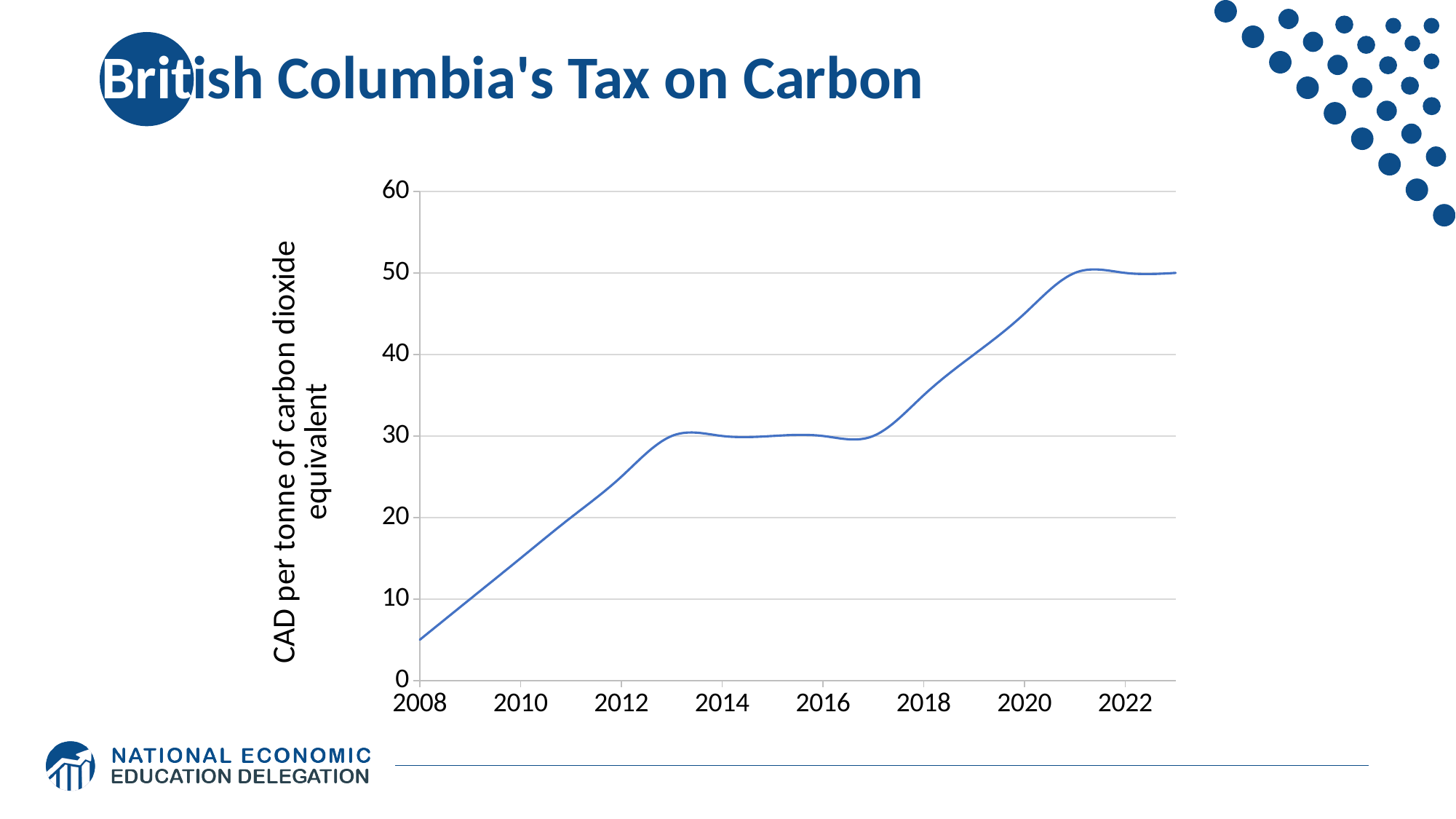
Which year has the larger value, 2014 or 2020? 2020 Is the value for 2012 greater or less than 20? greater In which year shown on the x axis is the carbon tax rate lowest? 2008 Is the value for 2008 greater or less than 10? less What is the title of the chart on the slide? British Columbia's Tax on Carbon Is the value for 2022 greater or less than 40? greater What kind of chart is shown on the slide? line chart Overall, does the carbon tax rate rise or fall from 2008 to 2022? rise How many year labels are shown on the x axis? 8 What is the label on the vertical axis of the chart? CAD per tonne of carbon dioxide equivalent